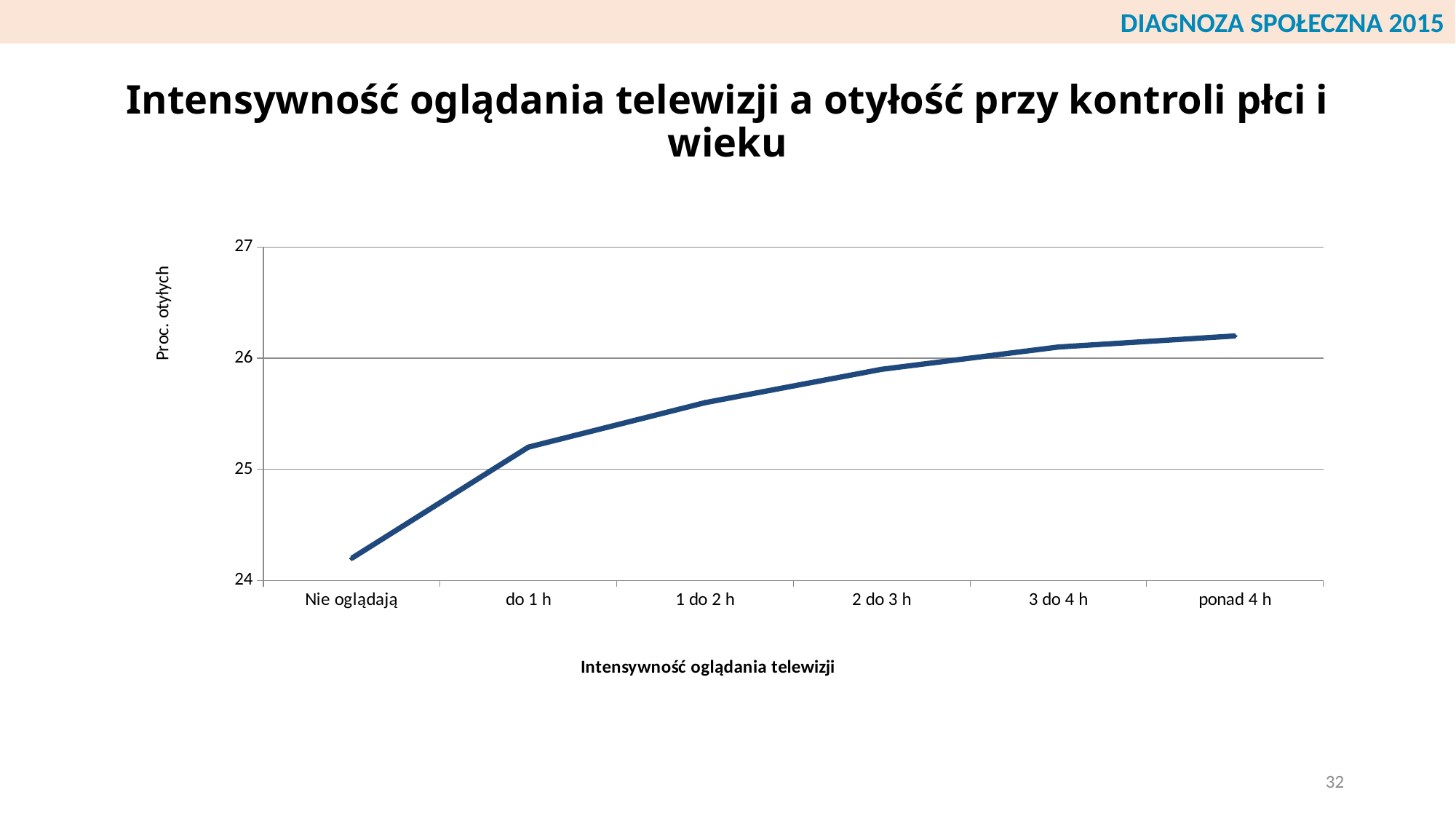
Is the value for 'ponad 4 h' greater or less than 26? greater What kind of chart is shown on the slide? Line chart Is the value for '1 do 2 h' greater or less than 26? less Is the value for 'do 1 h' greater or less than 25? greater Which is larger, the value for 'do 1 h' or the value for 'Nie oglądają'? do 1 h Which is larger, the value for '1 do 2 h' or the value for '3 do 4 h'? 3 do 4 h Which category has the lowest percentage of obese people? Nie oglądają How many categories are shown on the x axis? 6 Which category has the highest percentage of obese people? ponad 4 h Do the values rise or fall as television viewing intensity increases along the x axis? Rise What is the title of the vertical axis? Proc. otyłych